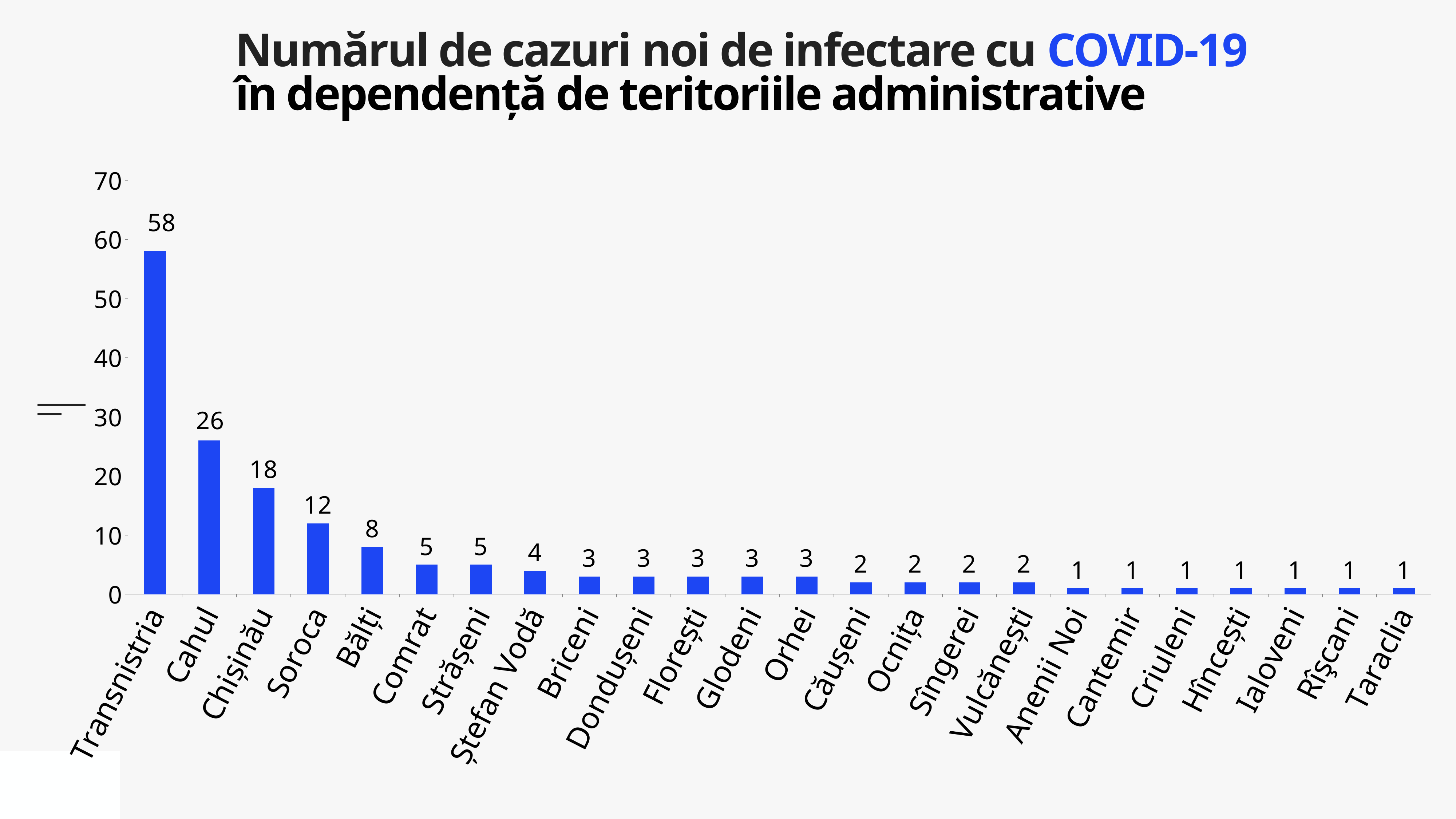
What value is shown for Soroca? 12 How many territories are shown on the x axis? 24 What value is shown for Orhei? 3 Which has a larger value, Comrat or Ștefan Vodă? Comrat What is the number of new cases shown for Chișinău? 18 Do the values rise or fall from left to right along the x axis? Fall What is the difference between the values for Transnistria and Cahul? 32 What is the difference between the values for Soroca and Bălți? 4 Which has a larger value, Cahul or Chișinău? Cahul What is the number of new COVID-19 cases for Transnistria? 58 What kind of chart is shown on the slide? Bar chart Which territory has the highest number of new cases? Transnistria